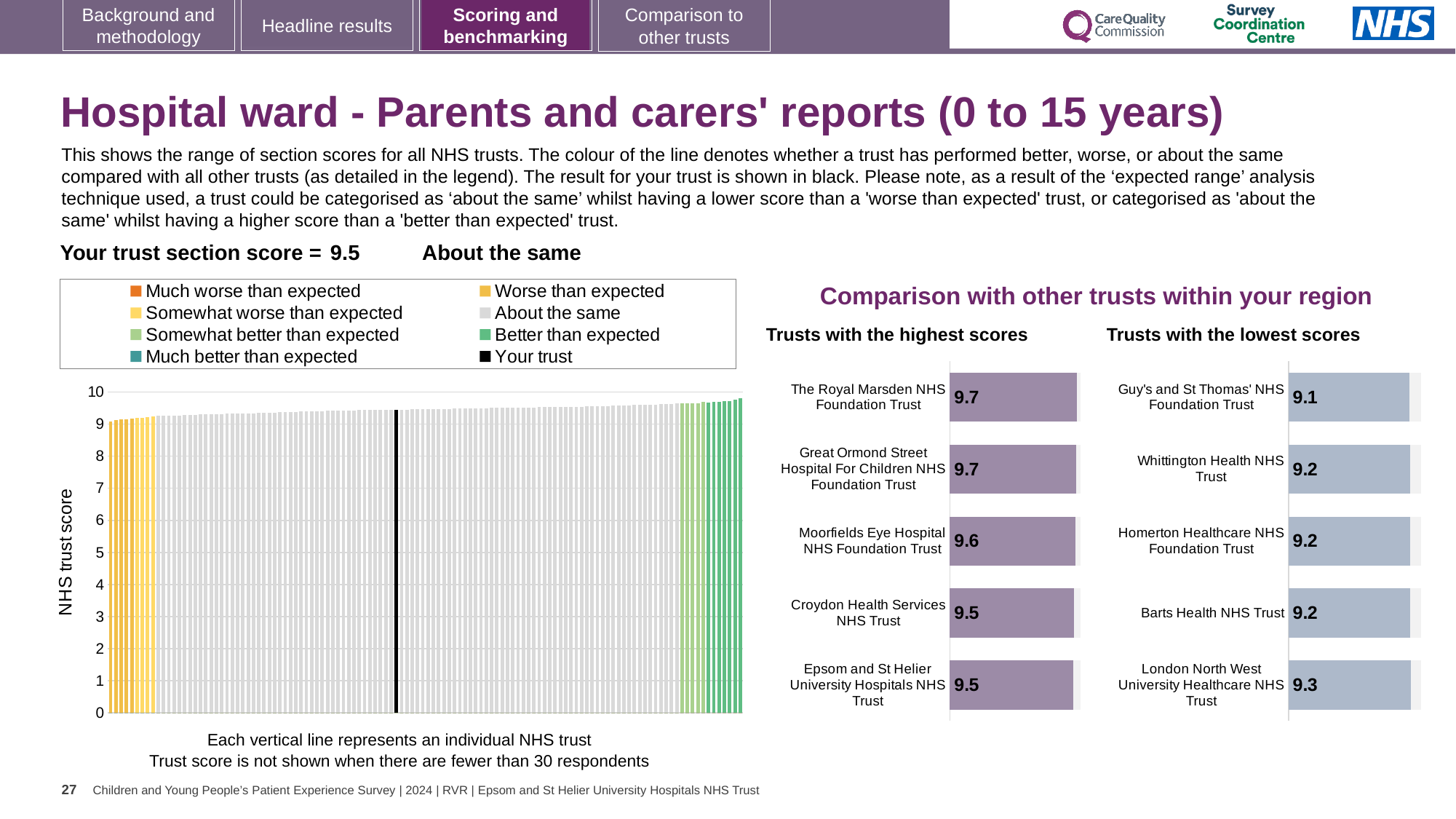
In the main 'NHS trust score' chart, do the values rise or fall from left to right along the x axis? Rise In the main 'NHS trust score' chart, is the value of the lowest bar greater or less than 8? greater How many entries does the legend of the main 'NHS trust score' chart list? 8 In the 'Trusts with the highest scores' chart, which has the higher score: Moorfields Eye Hospital NHS Foundation Trust or Croydon Health Services NHS Trust? Moorfields Eye Hospital NHS Foundation Trust In the 'Trusts with the lowest scores' chart, what is the score for Guy's and St Thomas' NHS Foundation Trust? 9.1 In the 'Trusts with the lowest scores' chart, which trust has the lowest score? Guy's and St Thomas' NHS Foundation Trust How many trusts are listed in the 'Trusts with the highest scores' chart? 5 What kind of chart is the main chart on the left showing NHS trust scores? Bar chart In the 'Trusts with the highest scores' chart, what is the score for The Royal Marsden NHS Foundation Trust? 9.7 In the 'Trusts with the highest scores' chart, what is the difference between the scores of The Royal Marsden NHS Foundation Trust and Croydon Health Services NHS Trust? 0.2 In the 'Trusts with the lowest scores' chart, which trust has the highest score? London North West University Healthcare NHS Trust In the 'Trusts with the lowest scores' chart, what is the score for Whittington Health NHS Trust? 9.2